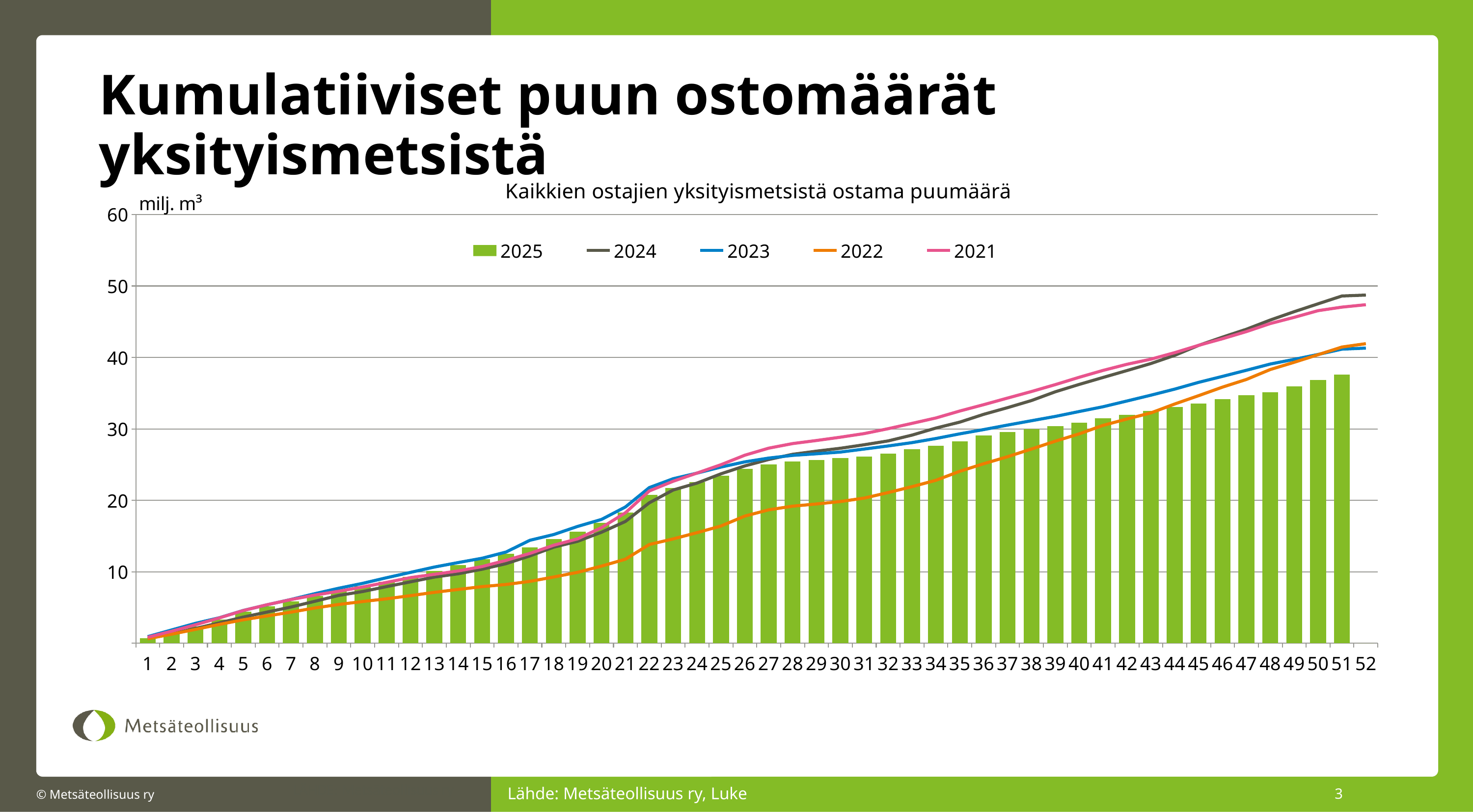
What is the title of the chart? Kaikkien ostajien yksityismetsistä ostama puumäärä How many weeks are shown on the x axis? 52 Which series is plotted as bars rather than a line? 2025 What kind of chart is this? Combined bar and line chart Do the values rise or fall along the x axis from week 1 to week 52? Rise Is the 2025 value at week 51 greater or less than 40? less Is the 2025 value at week 51 greater or less than 30? greater At week 40, which is larger, the 2021 value or the 2022 value? 2021 Is the 2024 value at week 52 greater or less than 40? greater Which series has the lowest value at week 30? 2022 How many series does the legend list? 5